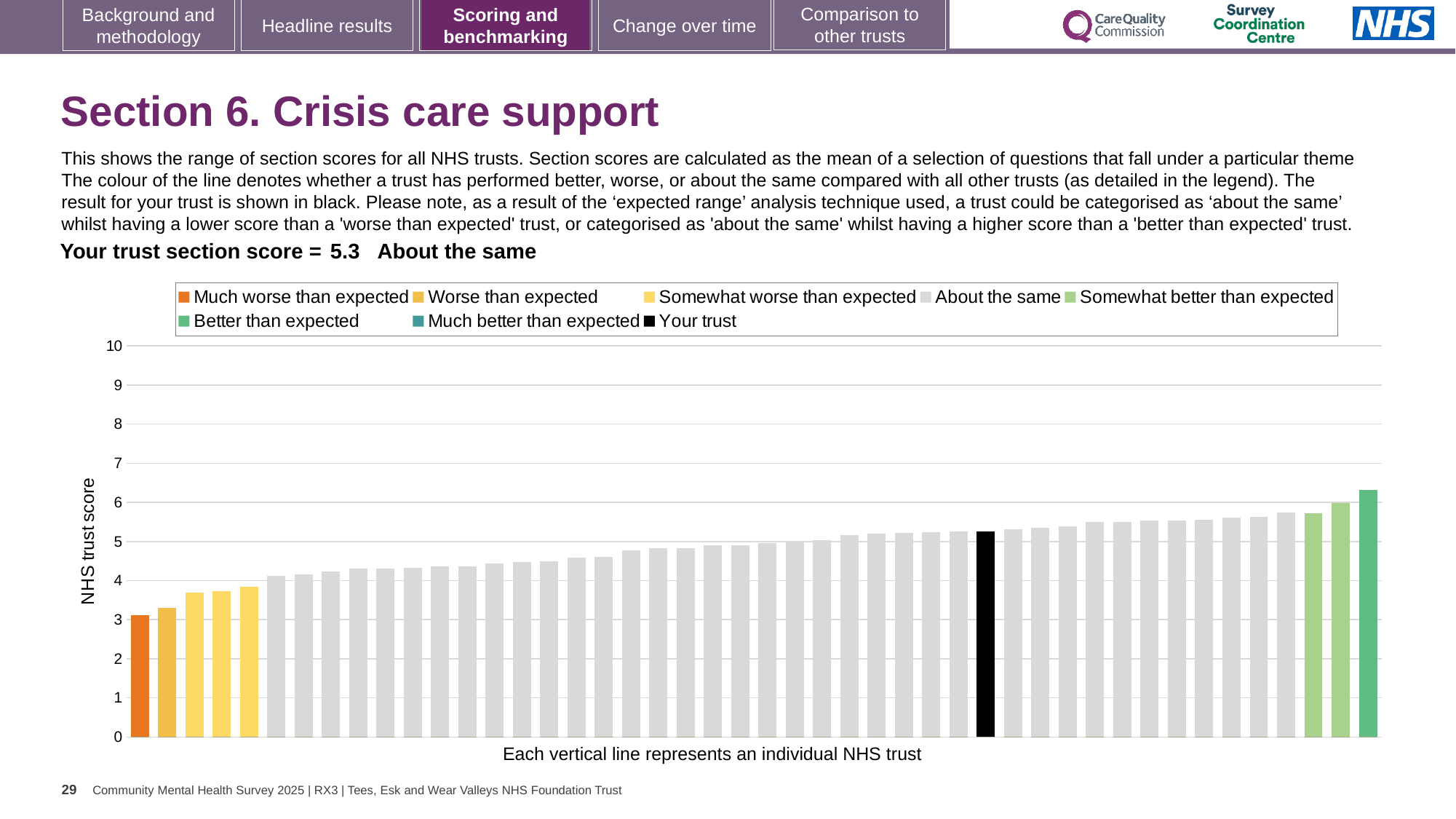
Which legend category has no bars plotted on the chart? Much better than expected Do the bar values rise or fall from left to right along the x axis? Rise Is the value of the highest bar (the green bar at the far right) greater or less than 6? greater How many bars are coloured as 'Somewhat worse than expected' (light yellow)? 3 Is the value of the black 'Your trust' bar greater or less than 5? greater Which legend category does the lowest bar on the chart belong to? Much worse than expected What is the section score for your trust shown on the slide? 5.3 Is the value of the lowest bar (the orange bar at the far left) greater or less than 4? less What kind of chart is shown on the slide? Bar chart Which legend category does the highest bar on the chart belong to? Better than expected How many entries does the chart legend list? 8